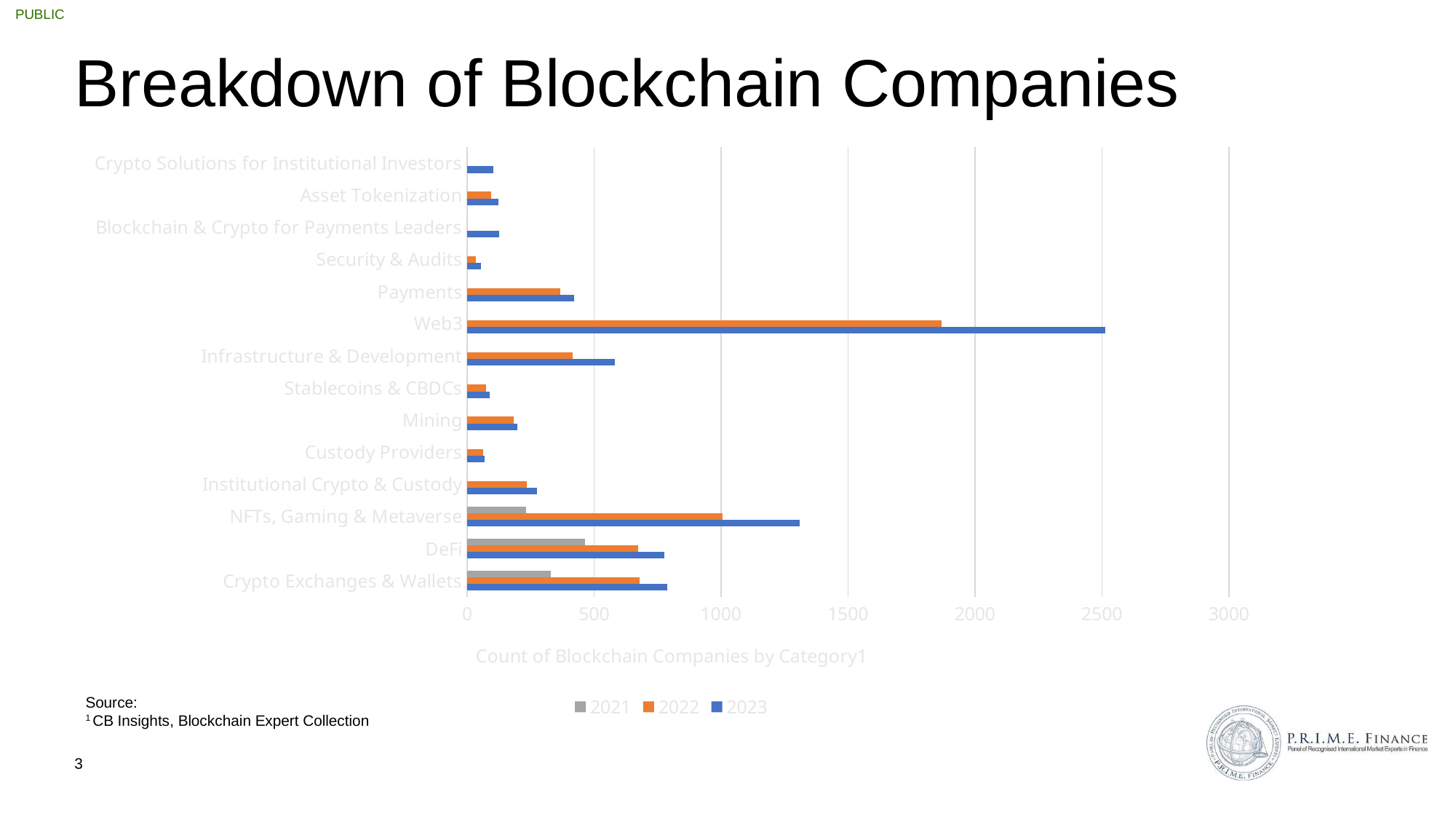
Is the 2022 value for Web3 greater or less than 1500? greater What kind of chart is shown on the slide? bar chart Which is larger: the 2022 value for Web3 or the 2022 value for NFTs, Gaming & Metaverse? Web3 How many series does the legend list? 3 Is the 2023 value for Web3 greater or less than 2000? greater Which category has the highest value for 2023? Web3 Which is larger: the 2023 value for NFTs, Gaming & Metaverse or the 2023 value for DeFi? NFTs, Gaming & Metaverse What are the entries in the chart's legend? 2021, 2022, 2023 Is the 2023 value for NFTs, Gaming & Metaverse greater or less than 1000? greater Which category has the highest value for 2021? DeFi How many categories are plotted on the chart? 14